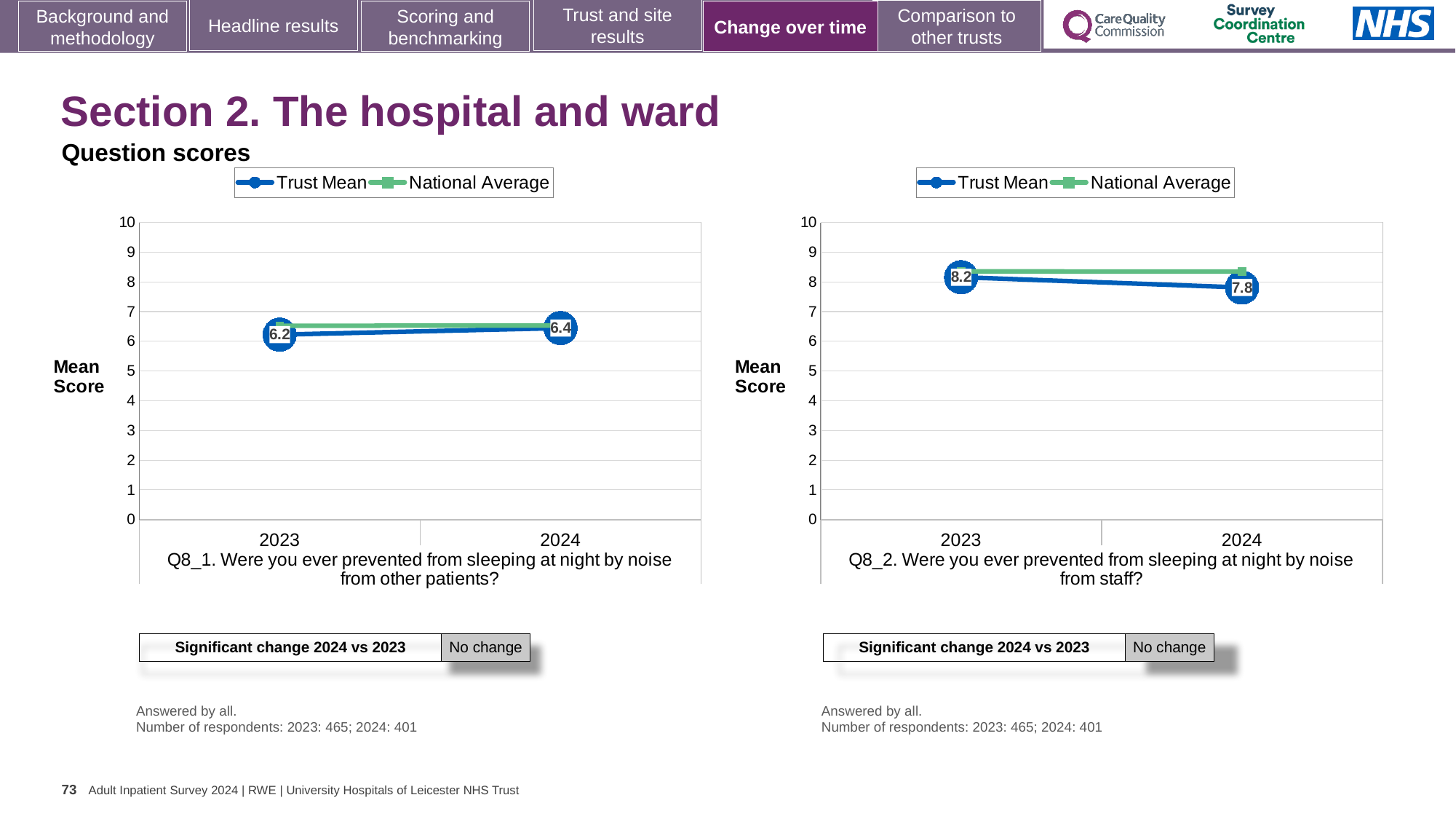
In the left chart (Q8_1, noise from other patients), is the National Average for 2023 greater or less than 7? less In the right chart (Q8_2, noise from staff), does the Trust Mean rise or fall from 2023 to 2024? fall In the right chart (Q8_2, noise from staff), by how much did the Trust Mean change from 2023 to 2024? 0.4 In the right chart (Q8_2, noise from staff), what is the Trust Mean score for 2024? 7.8 In the right chart (Q8_2, noise from staff), is the National Average for 2024 greater or less than 8? greater What type of chart is used for Q8_2 (noise from staff)? line chart How many series does the legend of the left chart (Q8_1) list? 2 In the left chart (Q8_1, noise from other patients), what is the Trust Mean score for 2024? 6.4 In the left chart (Q8_1, noise from other patients), what is the difference between the Trust Mean for 2024 and 2023? 0.2 In the right chart (Q8_2, noise from staff), what is the Trust Mean score for 2023? 8.2 In the left chart (Q8_1, noise from other patients), what is the Trust Mean score for 2023? 6.2 In the left chart (Q8_1, noise from other patients), does the Trust Mean rise or fall from 2023 to 2024? rise